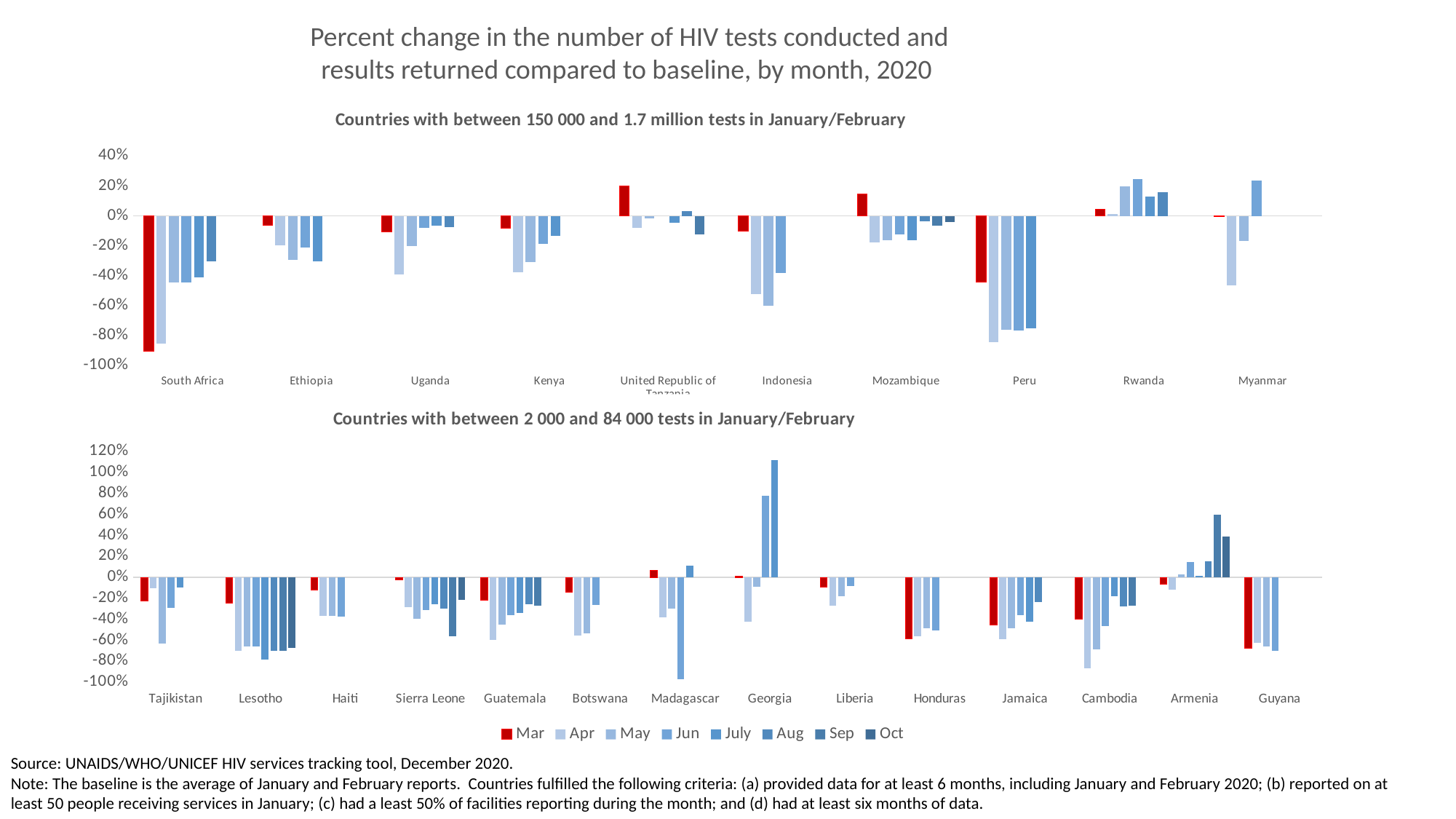
In the legend, which month is shown in red? Mar How many months (series) does the shared legend list for the charts? 8 In the top chart, is the April value for Peru greater or less than -80%? less How many countries are shown in the top chart, 'Countries with between 150 000 and 1.7 million tests in January/February'? 10 In the bottom chart, which country has the lowest bar of any month? Madagascar In the bottom chart, which country has the highest bar of any month? Georgia In the bottom chart, is the May value for Madagascar greater or less than -80%? greater In the top chart, is the March value for South Africa greater or less than -80%? less What kind of chart is the top chart, 'Countries with between 150 000 and 1.7 million tests in January/February'? Bar chart How many countries are shown in the bottom chart, 'Countries with between 2 000 and 84 000 tests in January/February'? 14